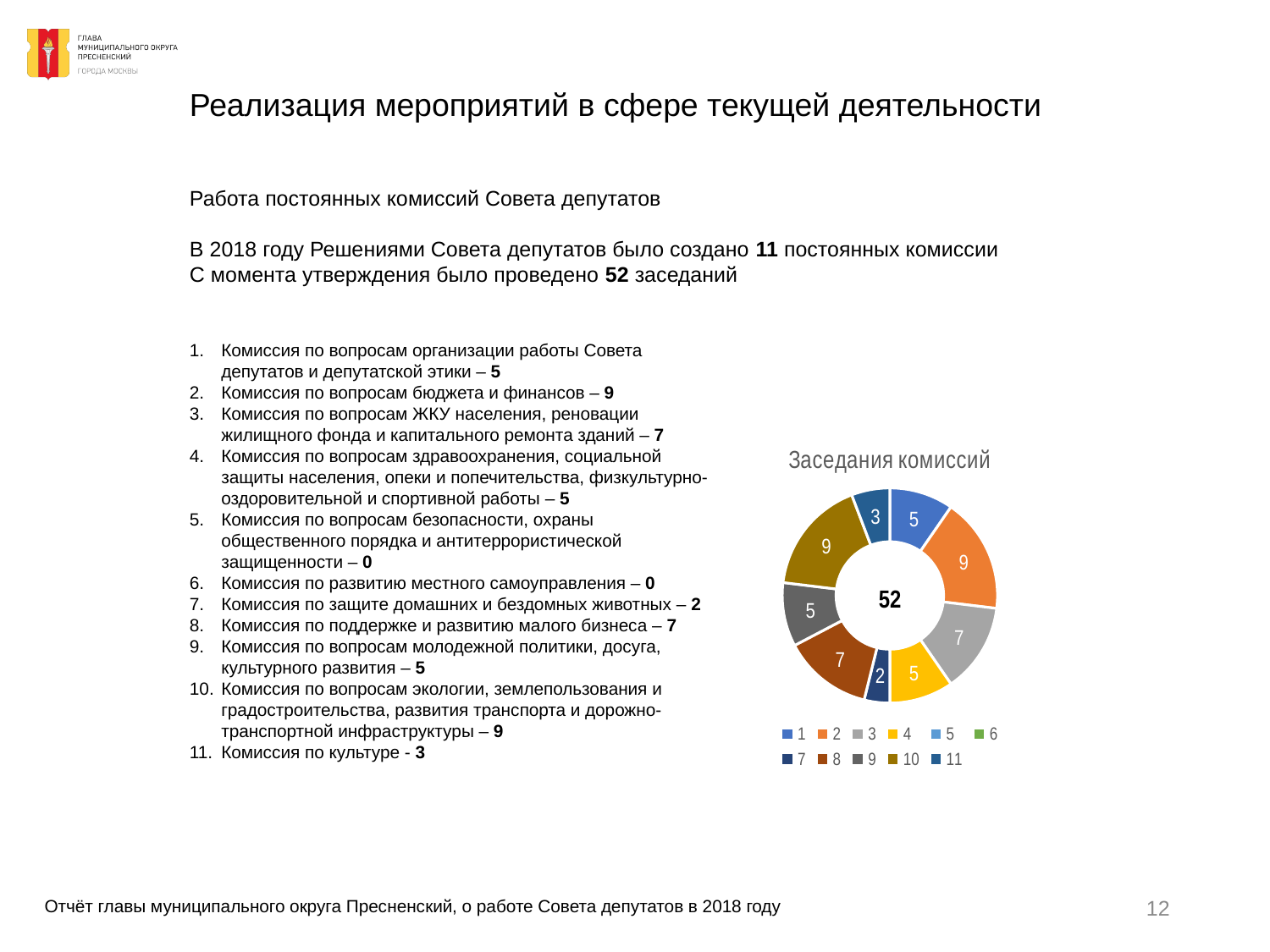
What is the value shown for category 11 in the 'Заседания комиссий' chart? 3 In the 'Заседания комиссий' chart, what is the difference between the value for category 2 and the value for category 7? 7 What type of chart is shown under the title 'Заседания комиссий'? doughnut (pie) chart What is the value shown for category 10 in the 'Заседания комиссий' chart? 9 What is the value shown for category 7 in the 'Заседания комиссий' chart? 2 How many entries does the legend of the 'Заседания комиссий' chart list? 11 What total number is printed in the centre of the 'Заседания комиссий' chart? 52 What is the title of the doughnut chart on the slide? Заседания комиссий In the 'Заседания комиссий' chart, what is the difference between the value for category 8 and the value for category 11? 4 What is the value shown for category 3 in the 'Заседания комиссий' chart? 7 What is the value shown for category 2 in the 'Заседания комиссий' chart? 9 In the 'Заседания комиссий' chart, which is larger: the value for category 2 or the value for category 1? category 2